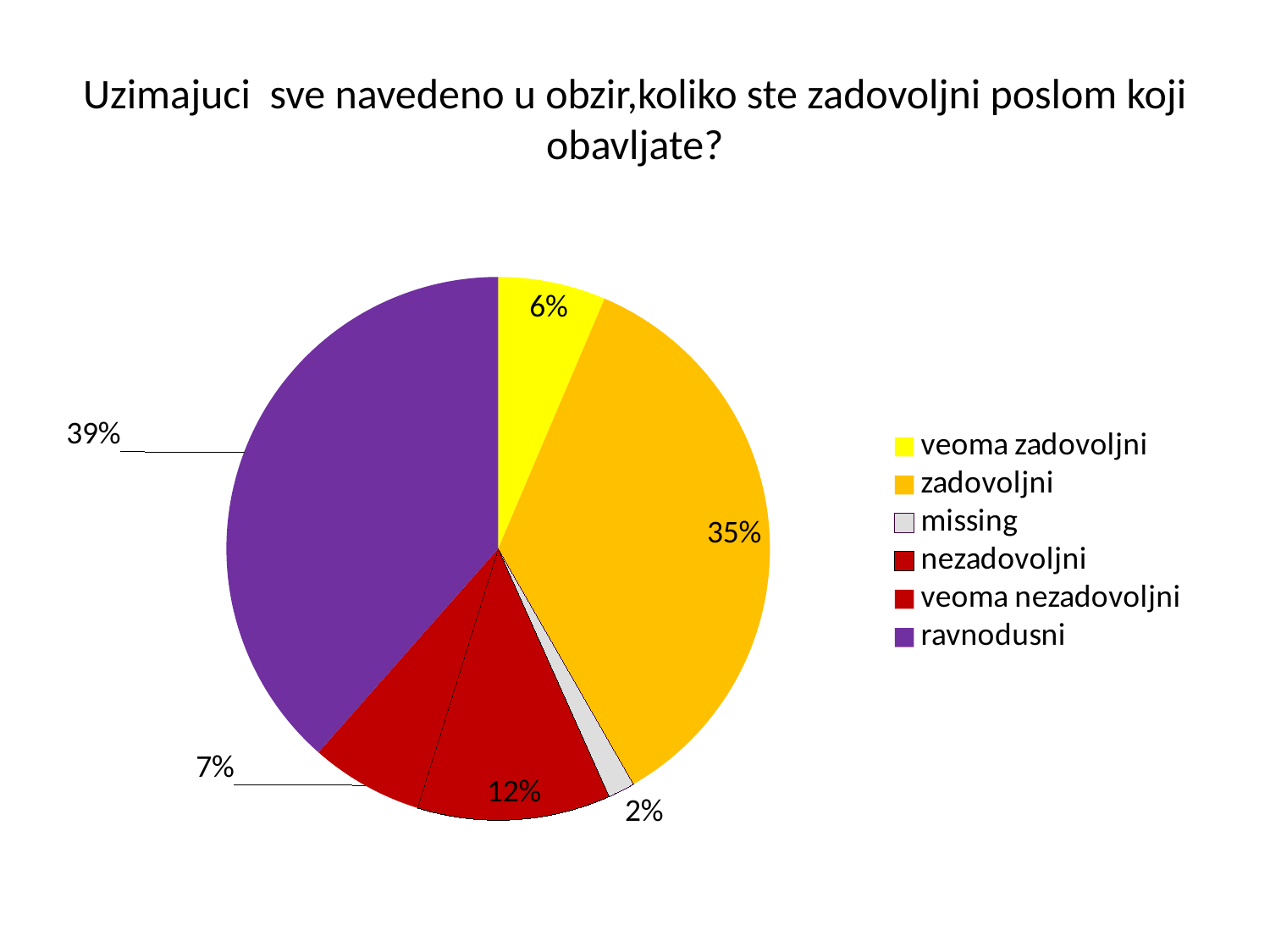
Which category has the largest slice of the pie? ravnodusni Which category has the smallest slice of the pie? missing What share of the pie is labelled "veoma zadovoljni"? 6% What share of the pie is labelled "missing"? 2% Which slice is larger, "nezadovoljni" or "veoma nezadovoljni"? nezadovoljni What share of the pie is labelled "zadovoljni"? 35% What is the difference in percentage points between the "ravnodusni" and "zadovoljni" slices? 4 How many categories does the legend list? 6 What colour is the "ravnodusni" slice? purple What kind of chart is shown on the slide? pie chart